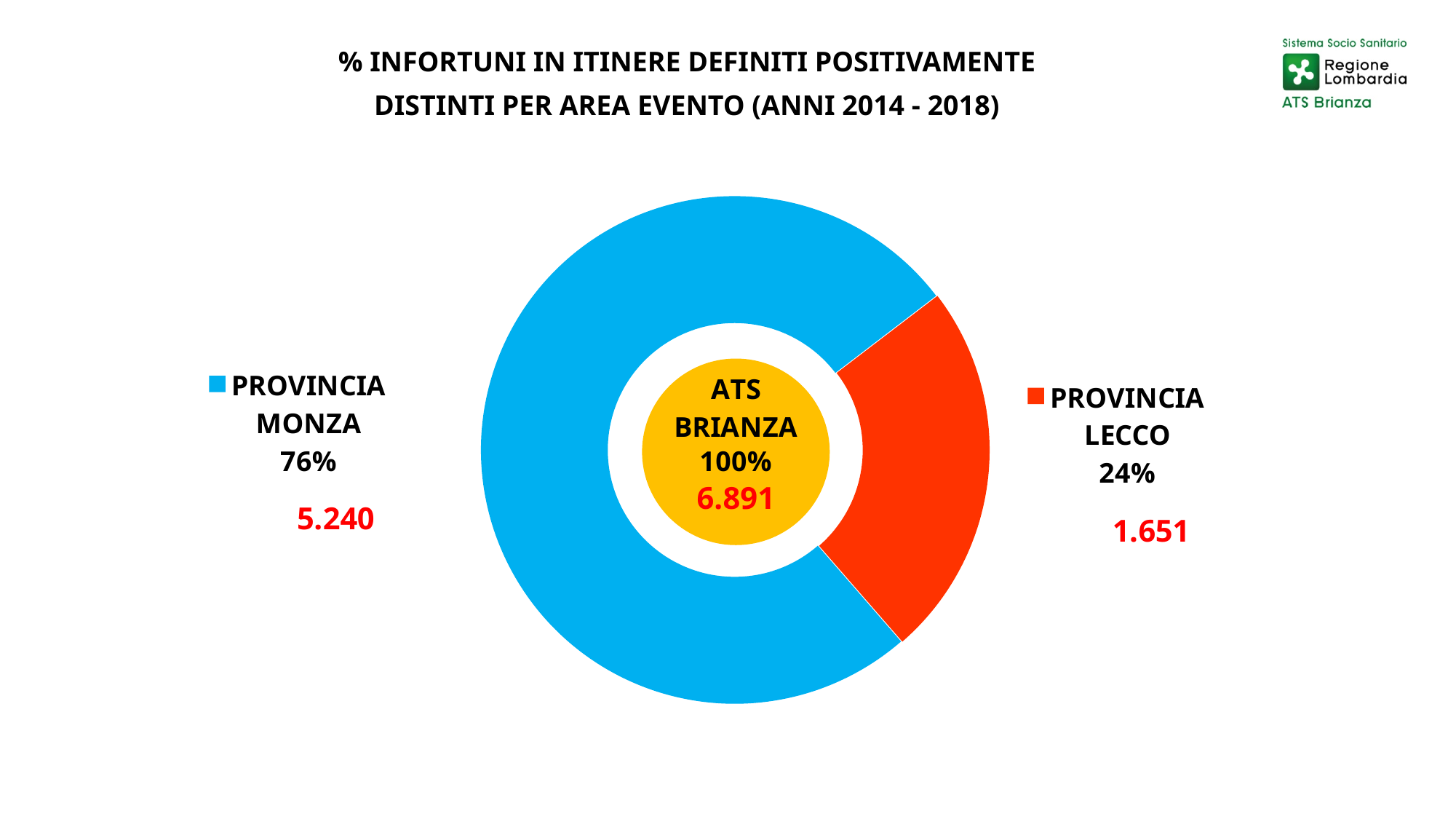
What colour represents PROVINCIA LECCO in the chart? Red Is the value for PROVINCIA MONZA larger or smaller than the value for PROVINCIA LECCO? larger What kind of chart is shown on the slide? Doughnut (pie) chart What is the number shown for PROVINCIA LECCO? 1.651 What is the number shown for PROVINCIA MONZA? 5.240 Which area has the larger share of the chart? PROVINCIA MONZA What percentage share does PROVINCIA MONZA have in the chart? 76% Which area has the smaller share of the chart? PROVINCIA LECCO How many categories are shown in the chart? 2 What is the difference in percentage points between PROVINCIA MONZA and PROVINCIA LECCO? 52 What percentage share does PROVINCIA LECCO have in the chart? 24% What total is shown in the centre of the chart for ATS BRIANZA? 6.891